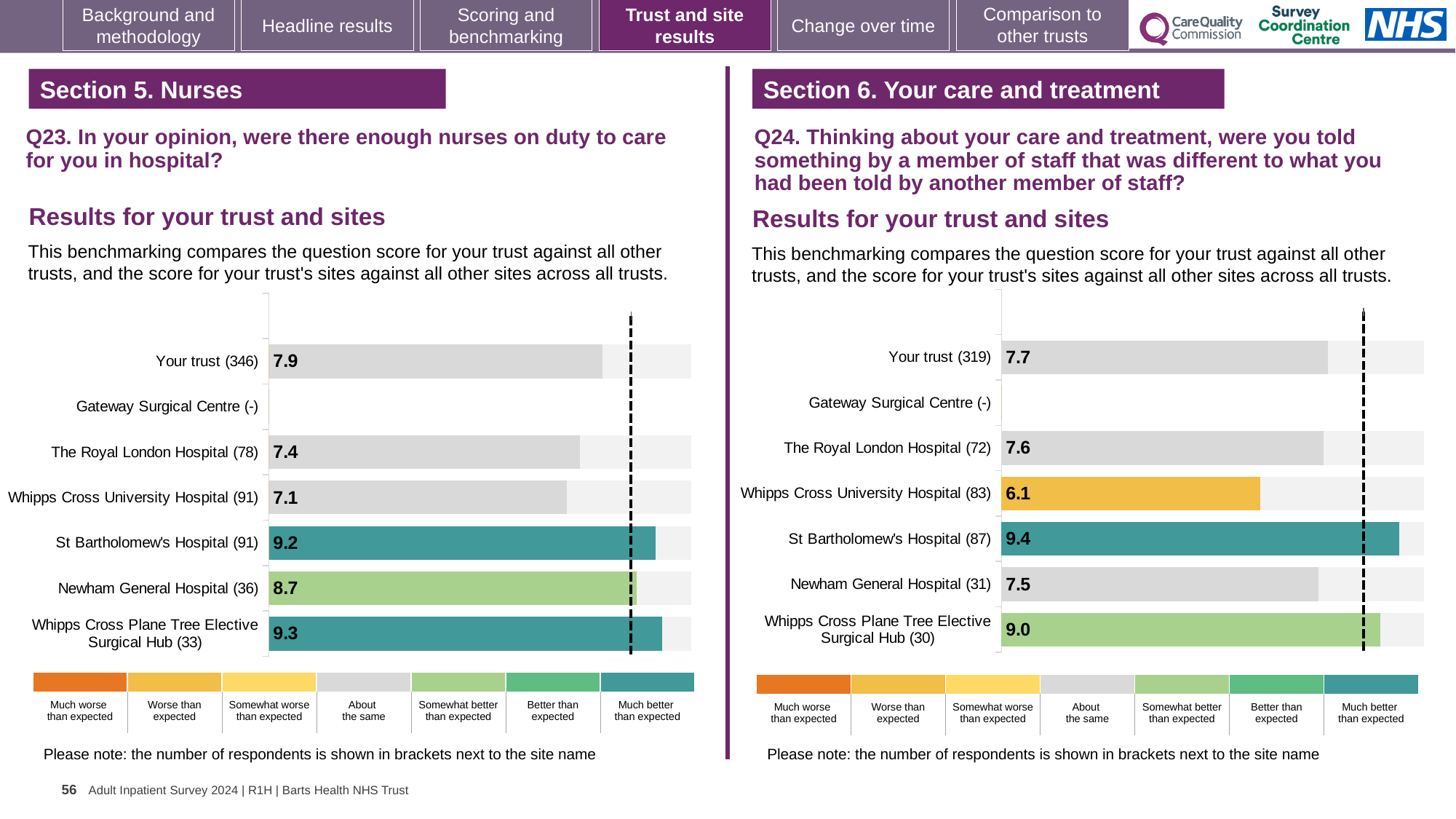
In the Q24 chart on the right, which site has the highest score? St Bartholomew's Hospital (87) In the Q24 chart on the right, what is the score for Newham General Hospital (31)? 7.5 In the Q23 chart on the left, which site with a score shown has the lowest score? Whipps Cross University Hospital (91) In the Q23 chart on the left, what is the score for Whipps Cross University Hospital (91)? 7.1 In the Q23 chart on the left, what is the difference between the scores for St Bartholomew's Hospital (91) and The Royal London Hospital (78)? 1.8 In the Q23 chart on the left, what is the score for Your trust (346)? 7.9 In the Q23 chart on the left, which site has the highest score? Whipps Cross Plane Tree Elective Surgical Hub (33) In the Q24 chart on the right, which is larger: the score for Your trust (319) or The Royal London Hospital (72)? Your trust (319) In the Q24 chart on the right, which site with a score shown has the lowest score? Whipps Cross University Hospital (83) How many sites or categories are listed on the y axis of the Q24 chart on the right? 7 In the Q24 chart on the right, what is the score for Whipps Cross University Hospital (83)? 6.1 What type of chart is used for the Q23 results on the left? Bar chart